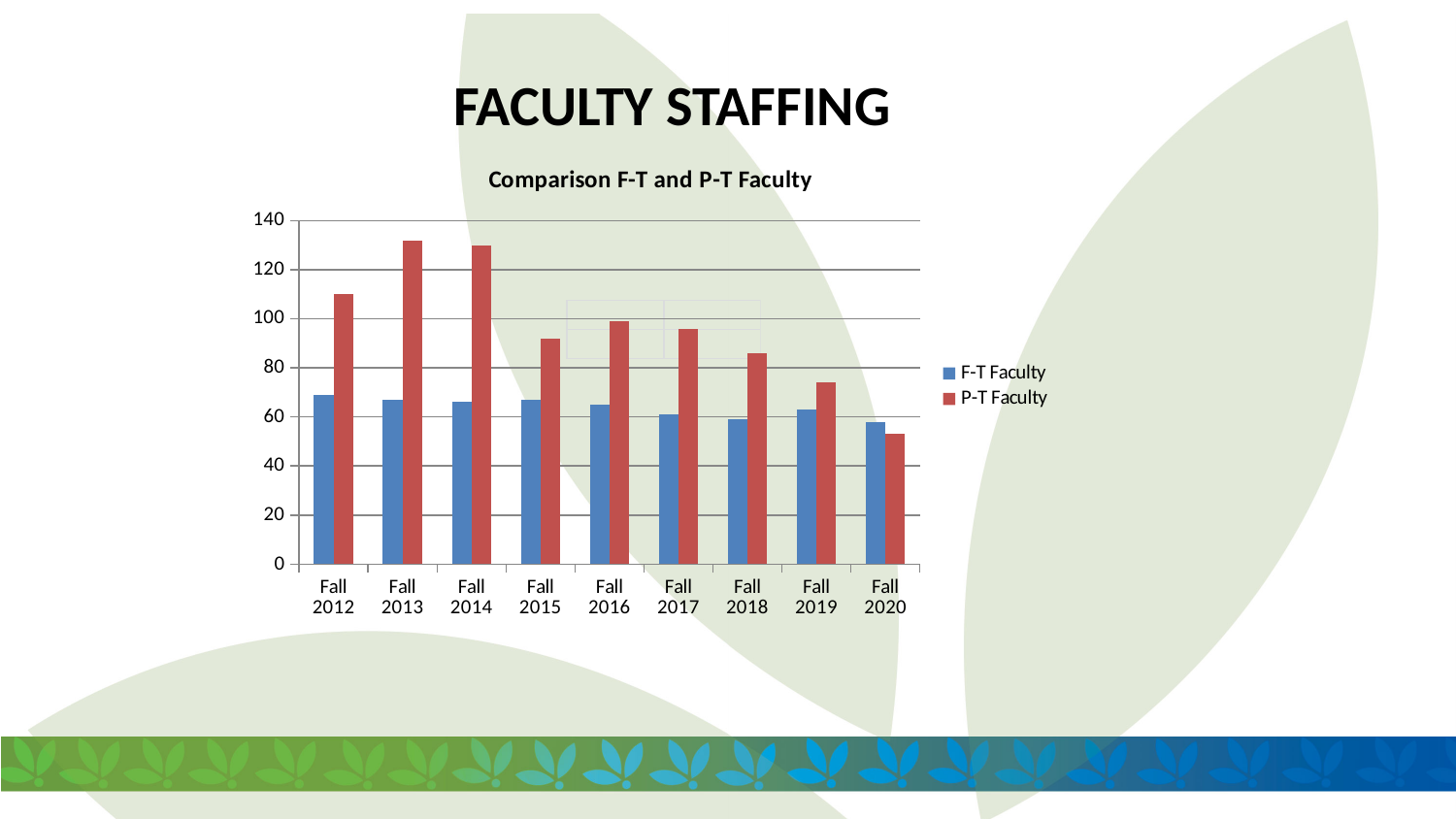
In Fall 2020, which is larger, F-T Faculty or P-T Faculty? F-T Faculty Is the value for P-T Faculty in Fall 2020 greater or less than 60? less How many series does the legend list? 2 Is the value for P-T Faculty in Fall 2012 greater or less than 100? greater What type of chart is shown on the slide? Bar chart What is the title of the chart? Comparison F-T and P-T Faculty In which Fall term is the P-T Faculty value lowest? Fall 2020 Which colour represents P-T Faculty in the chart? Red Is the value for P-T Faculty in Fall 2013 greater or less than 120? greater From Fall 2016 to Fall 2020, do the P-T Faculty values rise or fall? Fall How many Fall terms are shown on the x axis? 9